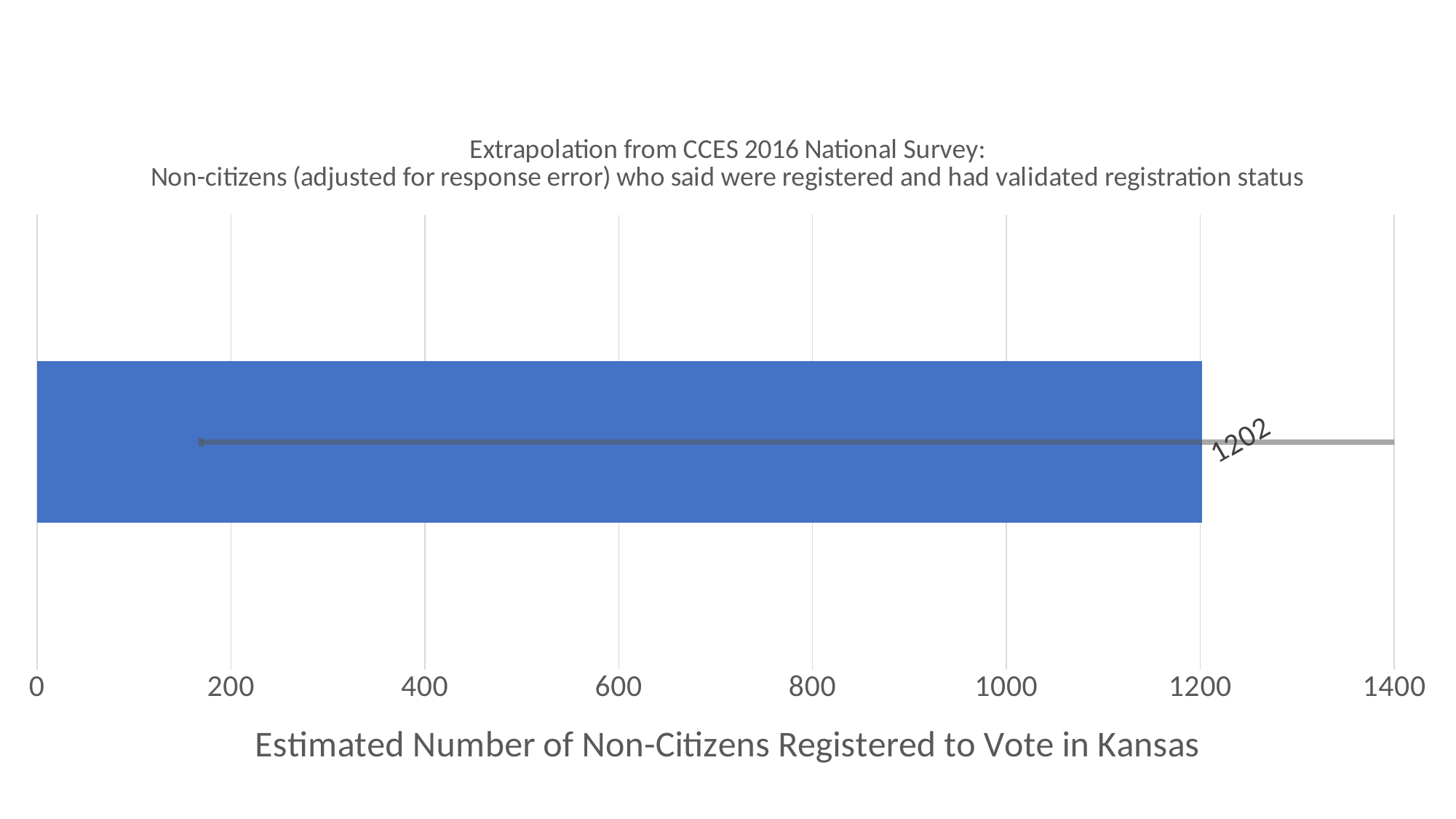
What kind of chart is shown on the slide? bar chart Is the value of the bar greater or less than 1400? less What is the estimated number of non-citizens registered to vote in Kansas shown on the chart? 1202 What is the highest tick value shown on the horizontal axis? 1400 Is the value of the bar greater or less than 800? greater How many bars are plotted on the chart? 1 What is the title of the horizontal axis? Estimated Number of Non-Citizens Registered to Vote in Kansas Is the value of the bar greater or less than 1000? greater What is the value shown by the data label on the bar? 1202